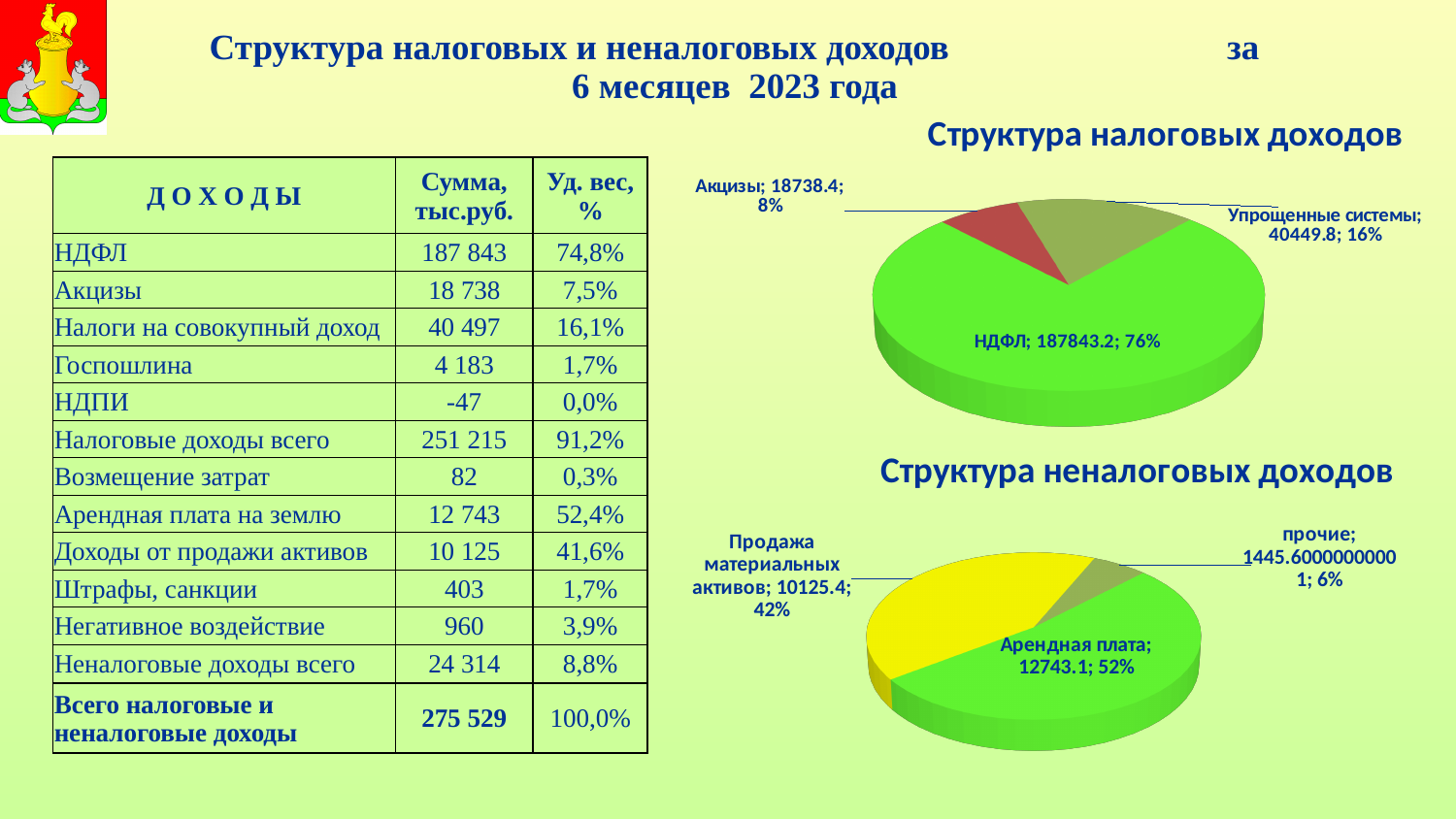
In the chart titled 'Структура налоговых доходов', what share of the pie does Упрощенные системы have? 16% What kind of chart is 'Структура неналоговых доходов'? Pie chart In the chart titled 'Структура неналоговых доходов', what is the difference between the values for Арендная плата and Продажа материальных активов? 2617.7 In the chart titled 'Структура неналоговых доходов', which is larger: Арендная плата or Продажа материальных активов? Арендная плата In the chart titled 'Структура налоговых доходов', what share of the pie does Акцизы have? 8% In the chart titled 'Структура налоговых доходов', which category has the largest slice? НДФЛ In the chart titled 'Структура неналоговых доходов', what value is shown for Арендная плата? 12743.1 In the chart titled 'Структура неналоговых доходов', which category has the smallest slice? прочие In the chart titled 'Структура налоговых доходов', how many slices does the pie have? 3 In the chart titled 'Структура неналоговых доходов', what share of the pie does Продажа материальных активов have? 42% In the chart titled 'Структура налоговых доходов', which category has the smallest slice? Акцизы In the chart titled 'Структура налоговых доходов', what value is shown for НДФЛ? 187843.2